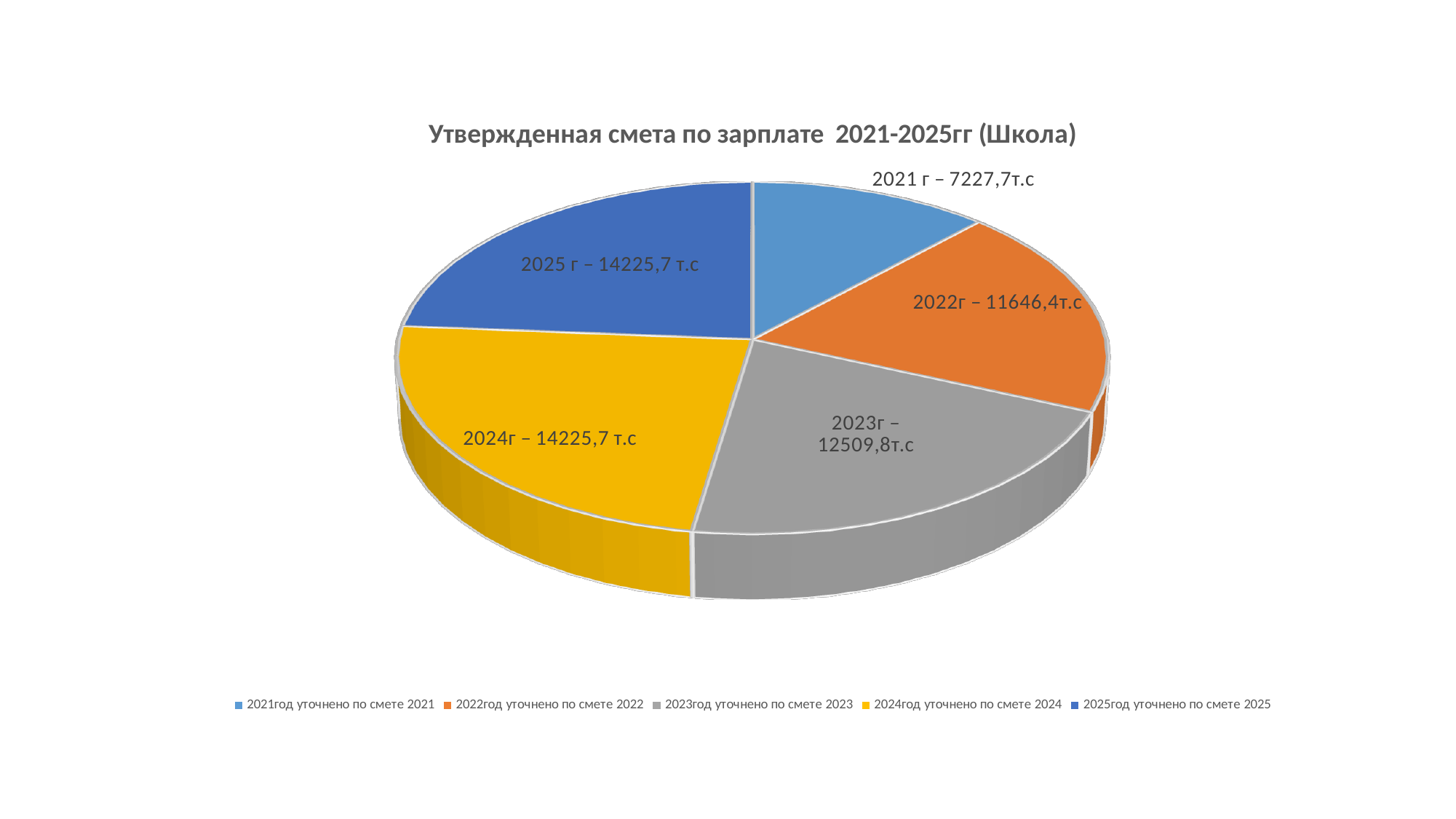
What is the value shown for 2025 on the pie chart? 14225,7 т.с Which year has the smallest slice in the pie chart? 2021 Which is larger, the value for 2023 or the value for 2022? 2023 What is the value shown for 2021 on the pie chart? 7227,7т.с What is the title of the chart? Утвержденная смета по зарплате 2021-2025гг (Школа) What is the difference between the 2023 value and the 2022 value? 863,4 What is the value shown for 2023 on the pie chart? 12509,8т.с Which is larger, the value for 2021 or the value for 2025? 2025 How many slices does the pie chart have? 5 What is the difference between the 2022 value and the 2021 value? 4418,7 What is the value shown for 2022 on the pie chart? 11646,4т.с What kind of chart is shown on the slide? Pie chart